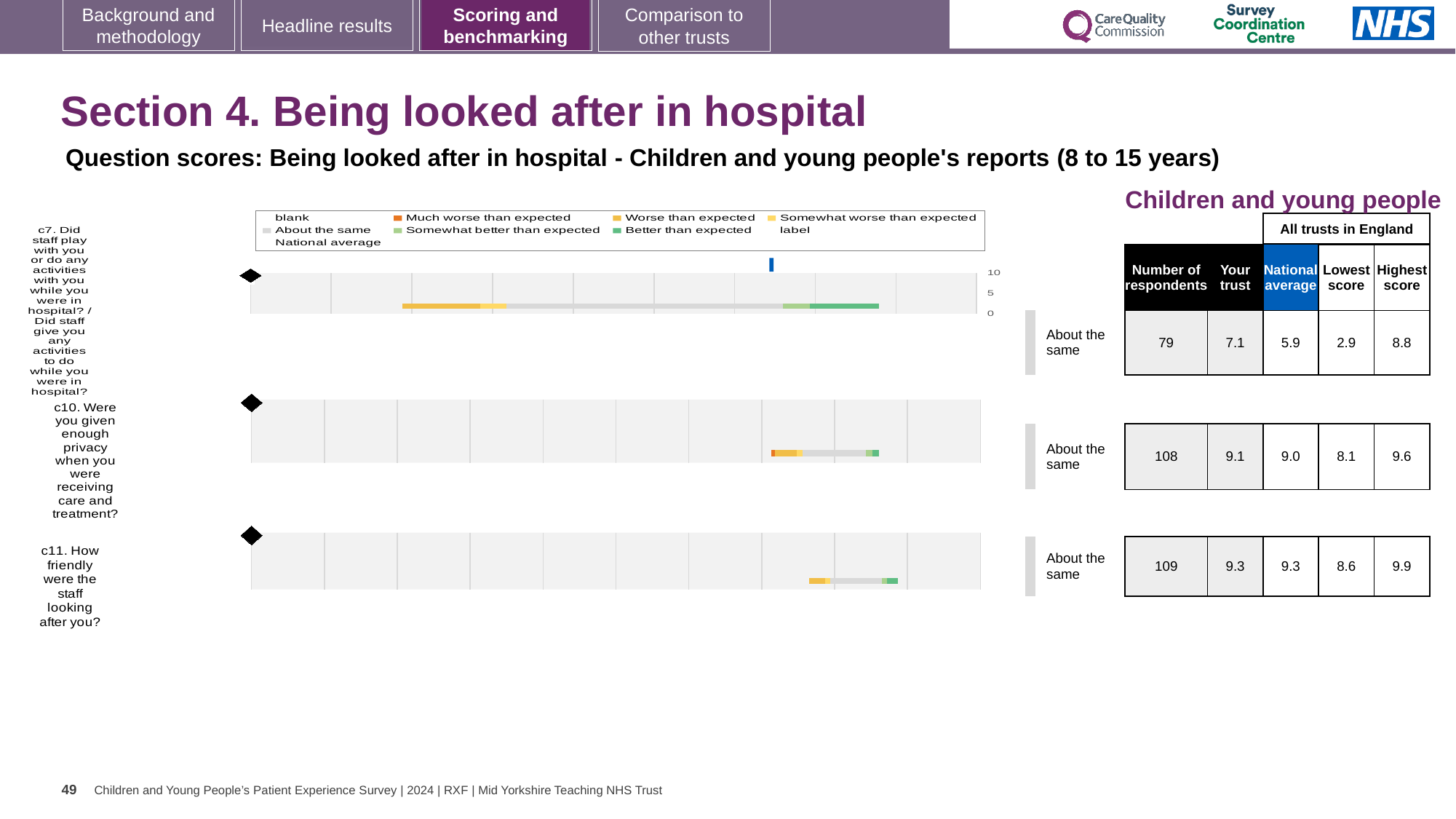
What is the highest score among all trusts in England for question c10? 9.6 What kind of chart is used to show the question scores on this slide? bar chart What is the national average score for question c7 (Did staff play with you or do any activities with you while you were in hospital?)? 5.9 Which question has the highest 'Your trust' score? c11 Which question has the lowest 'Your trust' score? c7 What benchmark category is shown next to the bar for question c7? About the same What is the 'Your trust' score for question c10 (Were you given enough privacy when you were receiving care and treatment?)? 9.1 For question c11, what is the difference between the highest score and the lowest score among all trusts in England? 1.3 For question c7, what is the difference between the 'Your trust' score and the national average? 1.2 How many respondents answered question c11 (How friendly were the staff looking after you?)? 109 For question c10, which is larger: the 'Your trust' score or the national average? Your trust How many questions (c7, c10, c11) have a benchmark bar on this slide? 3